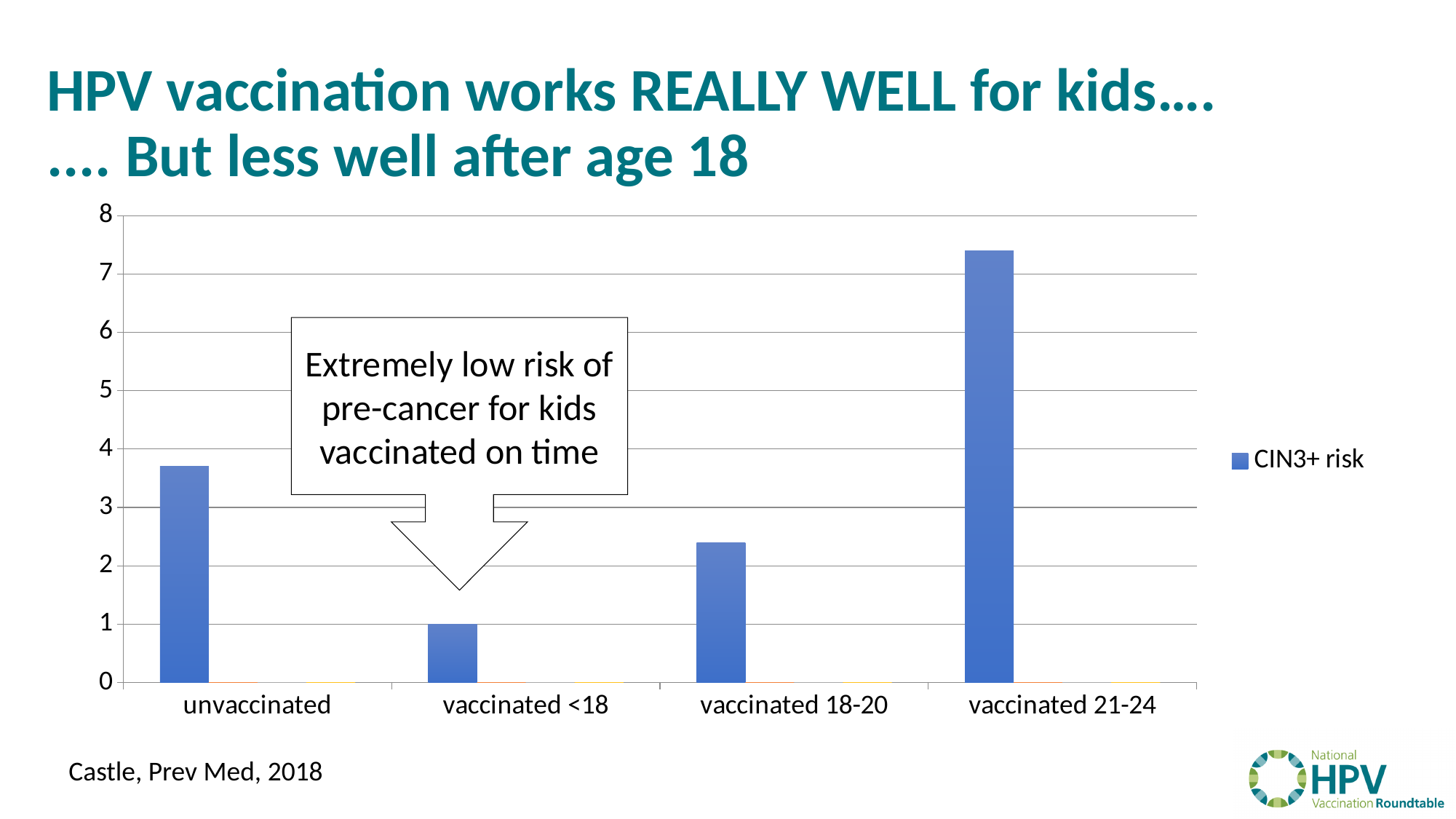
Is the CIN3+ risk for vaccinated 18-20 greater or less than 3? less How many series does the chart legend list? 1 Is the CIN3+ risk for unvaccinated greater or less than 3? greater Which category has the highest CIN3+ risk? vaccinated 21-24 What kind of chart is shown on the slide? bar chart How many categories are shown on the x axis of the chart? 4 Which has a higher CIN3+ risk, unvaccinated or vaccinated 18-20? unvaccinated Which category has the lowest CIN3+ risk? vaccinated <18 Which has a higher CIN3+ risk, vaccinated 21-24 or unvaccinated? vaccinated 21-24 Is the CIN3+ risk for vaccinated 21-24 greater or less than 7? greater What is the CIN3+ risk value for vaccinated <18? 1 What series name is shown in the chart legend? CIN3+ risk